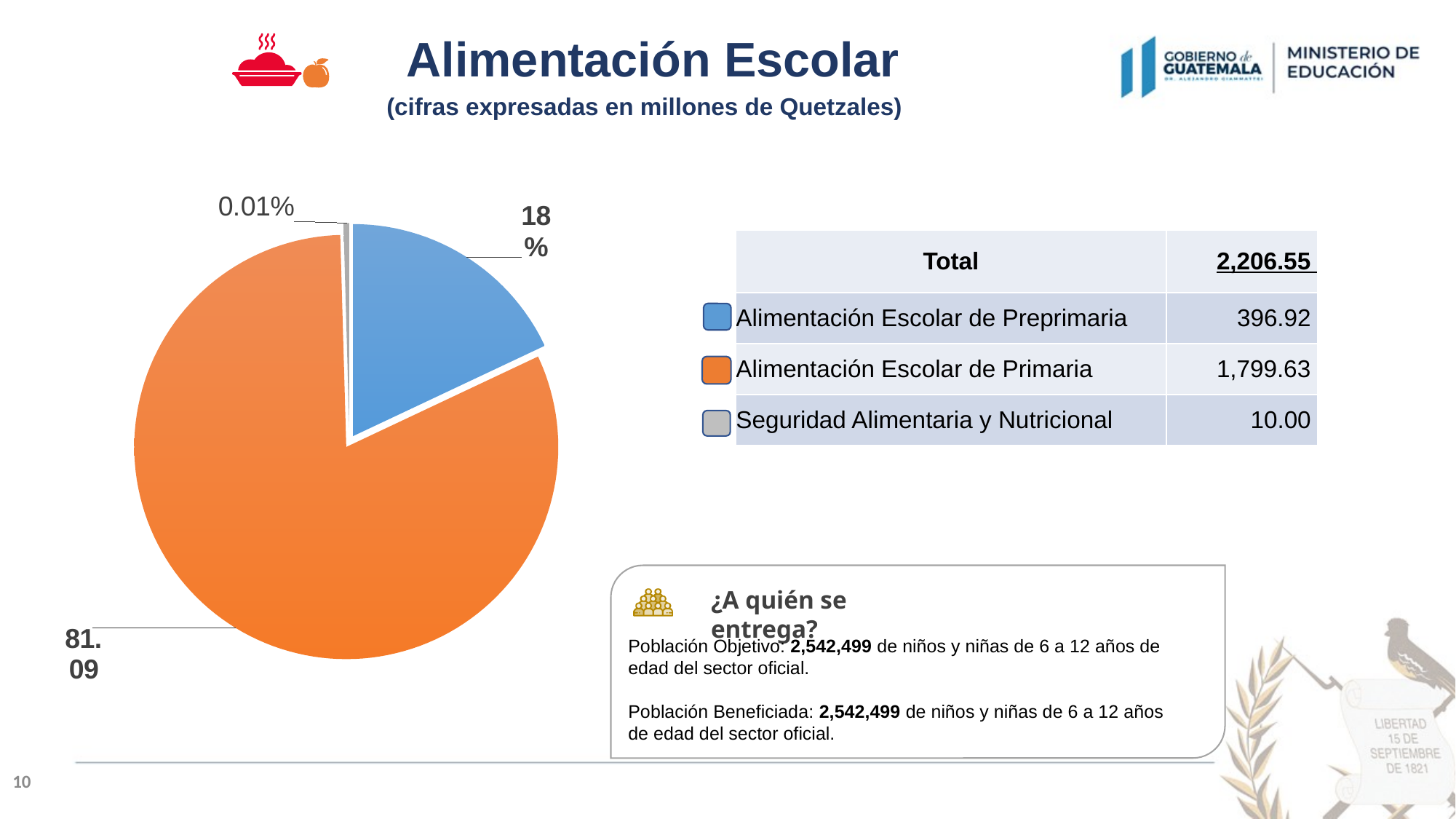
What is the total of all three categories shown? 2,206.55 How many slices does the pie chart have? 3 What is the value for Alimentación Escolar de Preprimaria? 396.92 What share of the pie is labelled for Seguridad Alimentaria y Nutricional? 0.01% What is the value for Alimentación Escolar de Primaria? 1,799.63 What share of the pie does Alimentación Escolar de Preprimaria represent? 18% What is the value for Seguridad Alimentaria y Nutricional? 10.00 Which category has the largest slice of the pie chart? Alimentación Escolar de Primaria Which category has the smallest slice of the pie chart? Seguridad Alimentaria y Nutricional What kind of chart is shown on the slide? pie chart Which colour is used for the Alimentación Escolar de Primaria slice? orange What is the difference between the values for Alimentación Escolar de Primaria and Alimentación Escolar de Preprimaria? 1,402.71